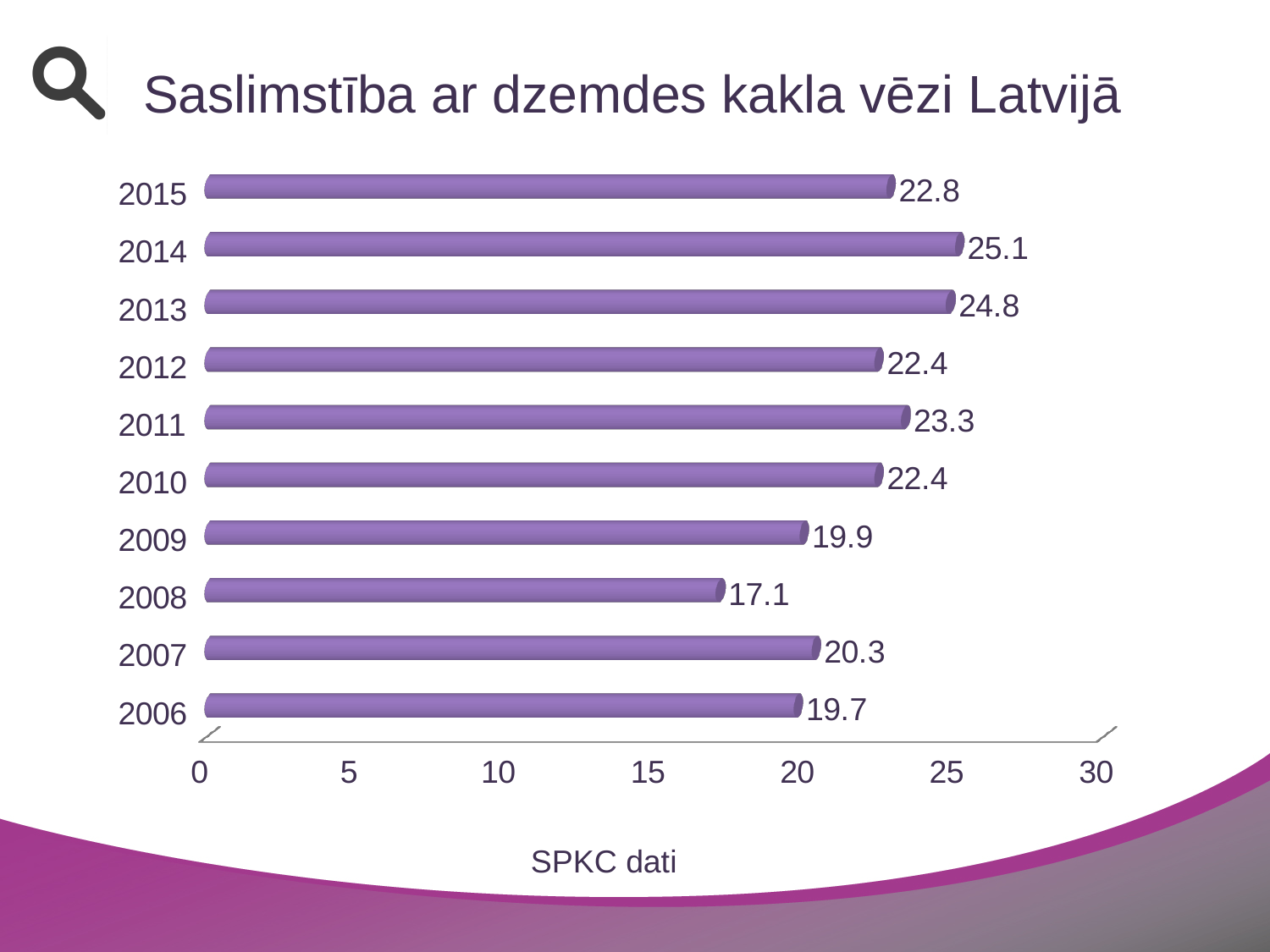
Which year has the lowest value? 2008 What is the value for 2015? 22.8 Which year has the highest value? 2014 What is the difference between the values for 2015 and 2006? 3.1 What is the value for 2008? 17.1 What is the value for 2011? 23.3 What is the title of the chart? Saslimstība ar dzemdes kakla vēzi Latvijā What is the difference between the values for 2014 and 2008? 8.0 Which is larger, the value for 2013 or the value for 2009? 2013 How many years are shown on the chart? 10 Is the value for 2007 greater or less than 25? less What kind of chart is shown on the slide? bar chart